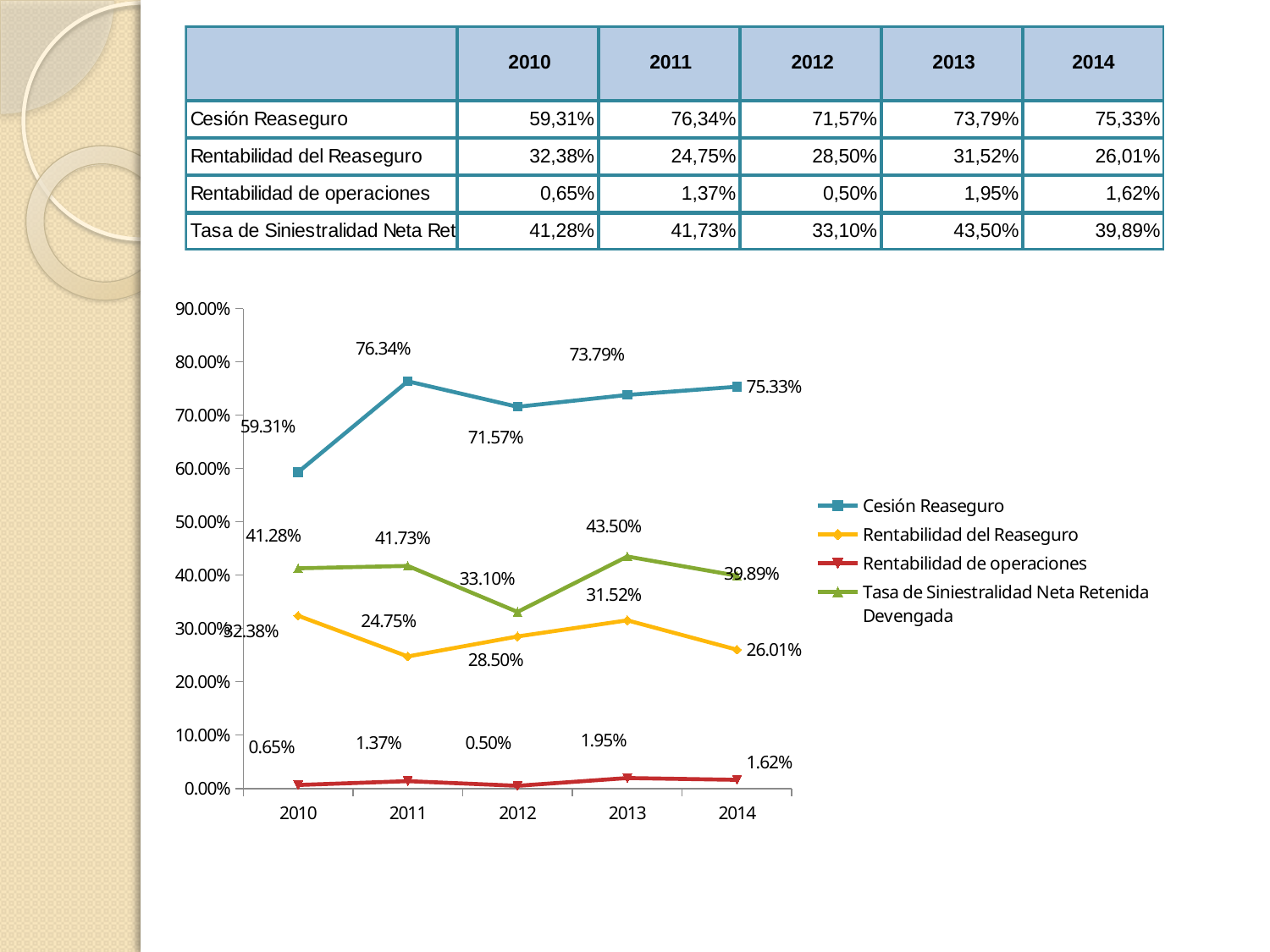
In which year is Cesión Reaseguro at its lowest on the chart? 2010 What is the value of Rentabilidad de operaciones in 2013 on the chart? 1.95% Which is larger on the chart: Rentabilidad del Reaseguro in 2010 or in 2011? 2010 What is the value of Tasa de Siniestralidad Neta Retenida Devengada in 2012 on the chart? 33.10% What kind of chart is shown on the slide? line chart How many years are plotted along the x axis of the chart? 5 What is the difference between the Cesión Reaseguro values for 2011 and 2010 on the chart? 17.03% How many series does the chart legend list? 4 Does Rentabilidad del Reaseguro rise or fall from 2013 to 2014 on the chart? fall In which year is Tasa de Siniestralidad Neta Retenida Devengada at its highest on the chart? 2013 What is the value of Cesión Reaseguro in 2011 on the chart? 76.34% Which series is drawn in green on the chart? Tasa de Siniestralidad Neta Retenida Devengada